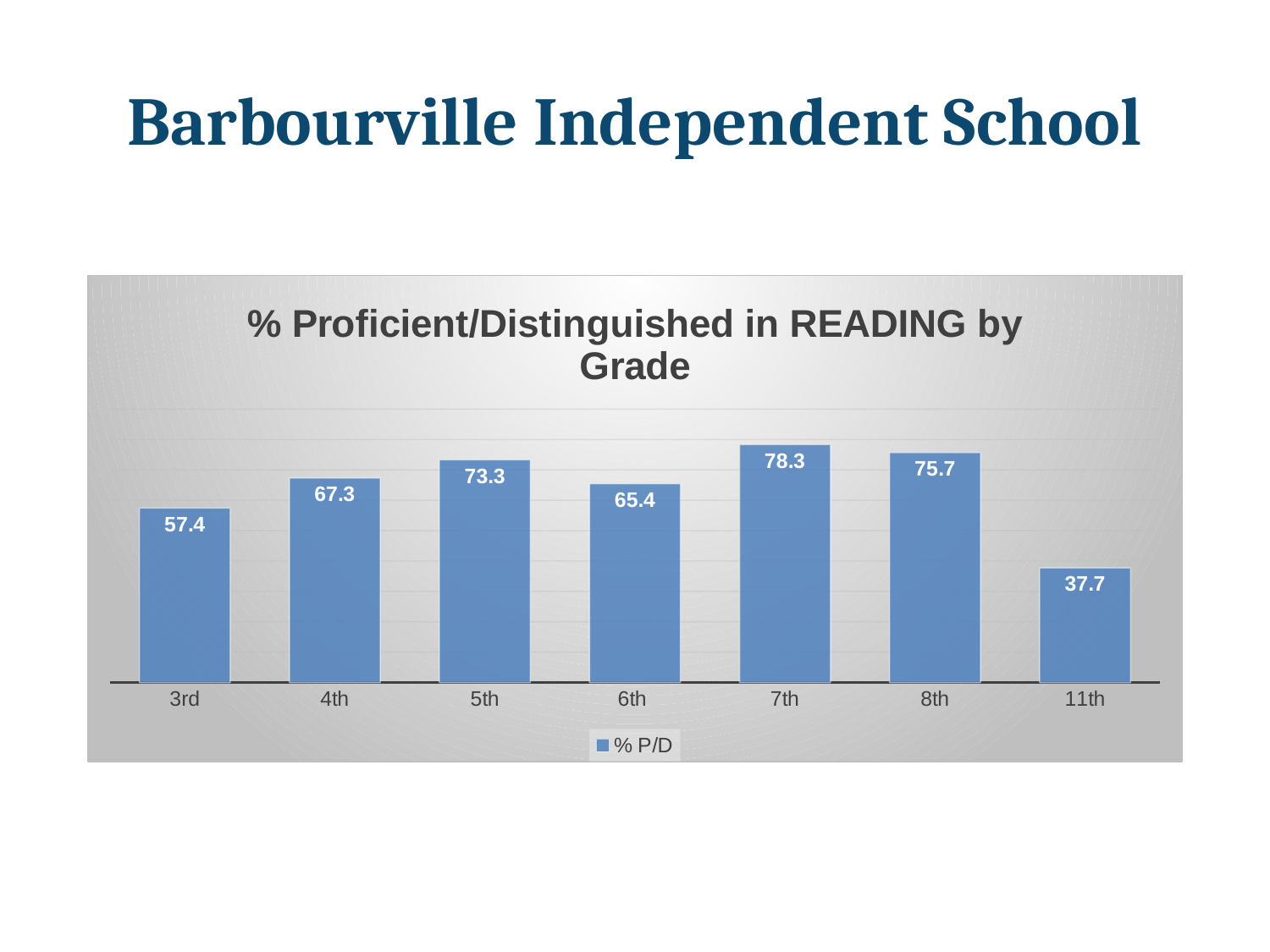
What kind of chart is shown on the slide? Bar chart What is the difference between the 7th grade and 11th grade values? 40.6 What is the % P/D value for 3rd grade? 57.4 How many grades are shown on the chart? 7 How many series does the legend list? 1 Which grade has the lowest % Proficient/Distinguished in reading? 11th What is the % P/D value for 11th grade? 37.7 What is the title of the chart? % Proficient/Distinguished in READING by Grade Which has a higher value, 4th grade or 8th grade? 8th Which grade has the highest % Proficient/Distinguished in reading? 7th What is the difference between the 5th grade and 6th grade values? 7.9 What is the % P/D value for 7th grade? 78.3